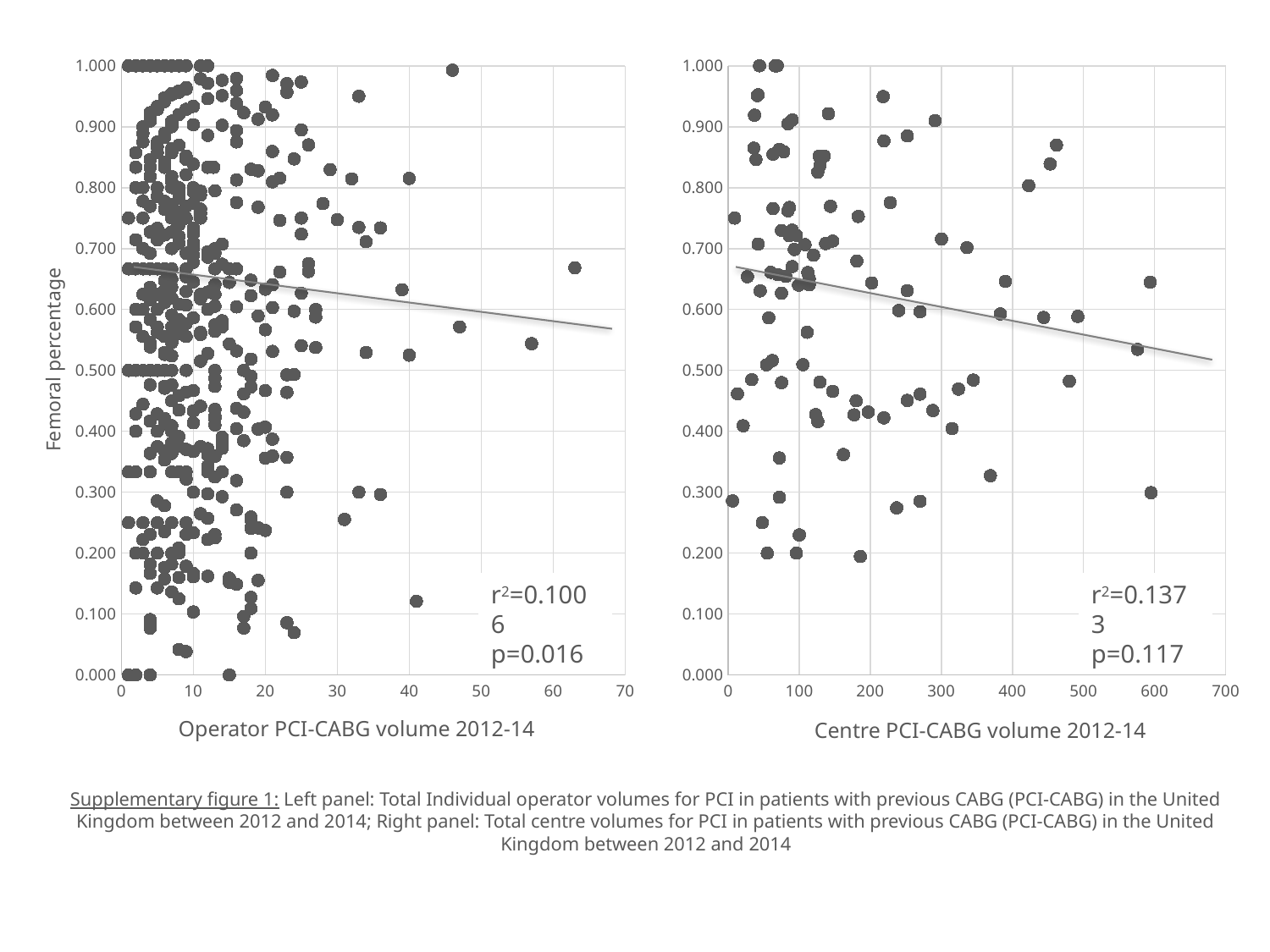
On the left chart (Operator PCI-CABG volume 2012-14), is the femoral percentage of the rightmost point (at about 63 on the x-axis) greater or less than 0.600? greater What is the label of the y-axis on the left chart? Femoral percentage Which chart shows the smaller p-value, the left (Operator) chart or the right (Centre) chart? the left (Operator) chart How many charts are shown on the slide? 2 What is the x-axis label of the right chart? Centre PCI-CABG volume 2012-14 What p-value is printed on the right chart (Centre PCI-CABG volume 2012-14)? p=0.117 On the right chart (Centre PCI-CABG volume 2012-14), does the fitted trend line rise or fall as centre volume increases? fall What p-value is printed on the left chart (Operator PCI-CABG volume 2012-14)? p=0.016 On the right chart (Centre PCI-CABG volume 2012-14), is the femoral percentage of the point at about 470 on the x-axis near the top of the plot greater or less than 0.800? greater What kind of chart is the left chart, titled 'Operator PCI-CABG volume 2012-14'? scatter plot On the left chart (Operator PCI-CABG volume 2012-14), does the fitted trend line rise or fall as operator volume increases? fall